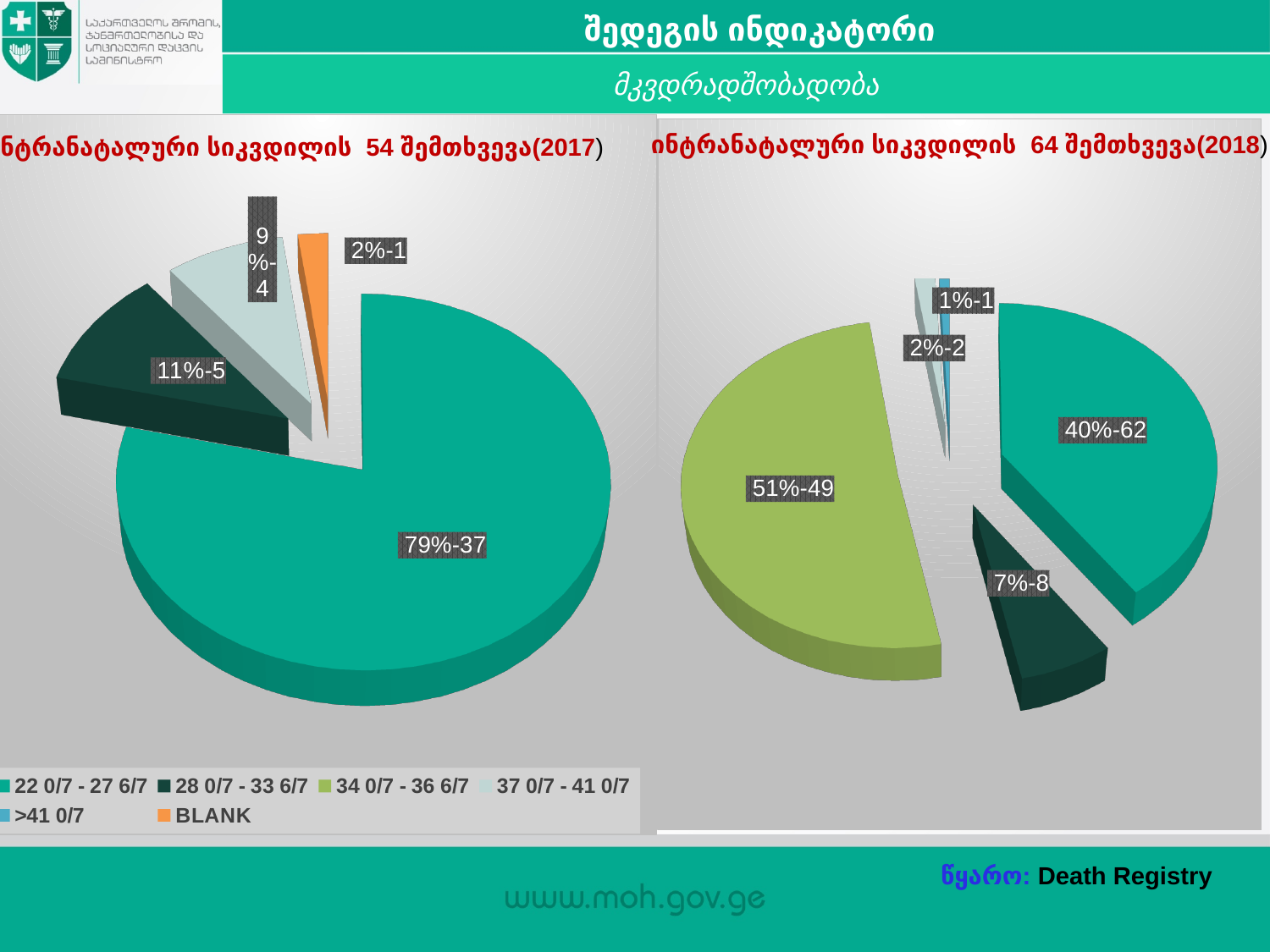
What kind of chart is used on the left (2017) side of the slide? Pie chart In the right (2018) pie chart, which is larger: the 34 0/7 - 36 6/7 slice or the 22 0/7 - 27 6/7 slice? 34 0/7 - 36 6/7 In the left (2017) pie chart, what label is shown on the dark green 28 0/7 - 33 6/7 slice? 11%-5 How many slices does the left (2017) pie chart have? 4 In the right (2018) pie chart, which slice is the smallest? >41 0/7 (1%-1) In the right (2018) pie chart, what label is shown on the dark green 28 0/7 - 33 6/7 slice? 7%-8 In the left (2017) pie chart, what share of the pie does the 37 0/7 - 41 0/7 slice represent? 9% In the left (2017) pie chart, which legend category does the largest slice (79%-37) belong to? 22 0/7 - 27 6/7 In the left (2017) pie chart, what label is shown on the BLANK (orange) slice? 2%-1 In the left (2017) pie chart, what label is shown on the largest slice? 79%-37 In the right (2018) pie chart, what label is shown on the light green 34 0/7 - 36 6/7 slice? 51%-49 How many categories does the legend at the bottom of the slide list? 6